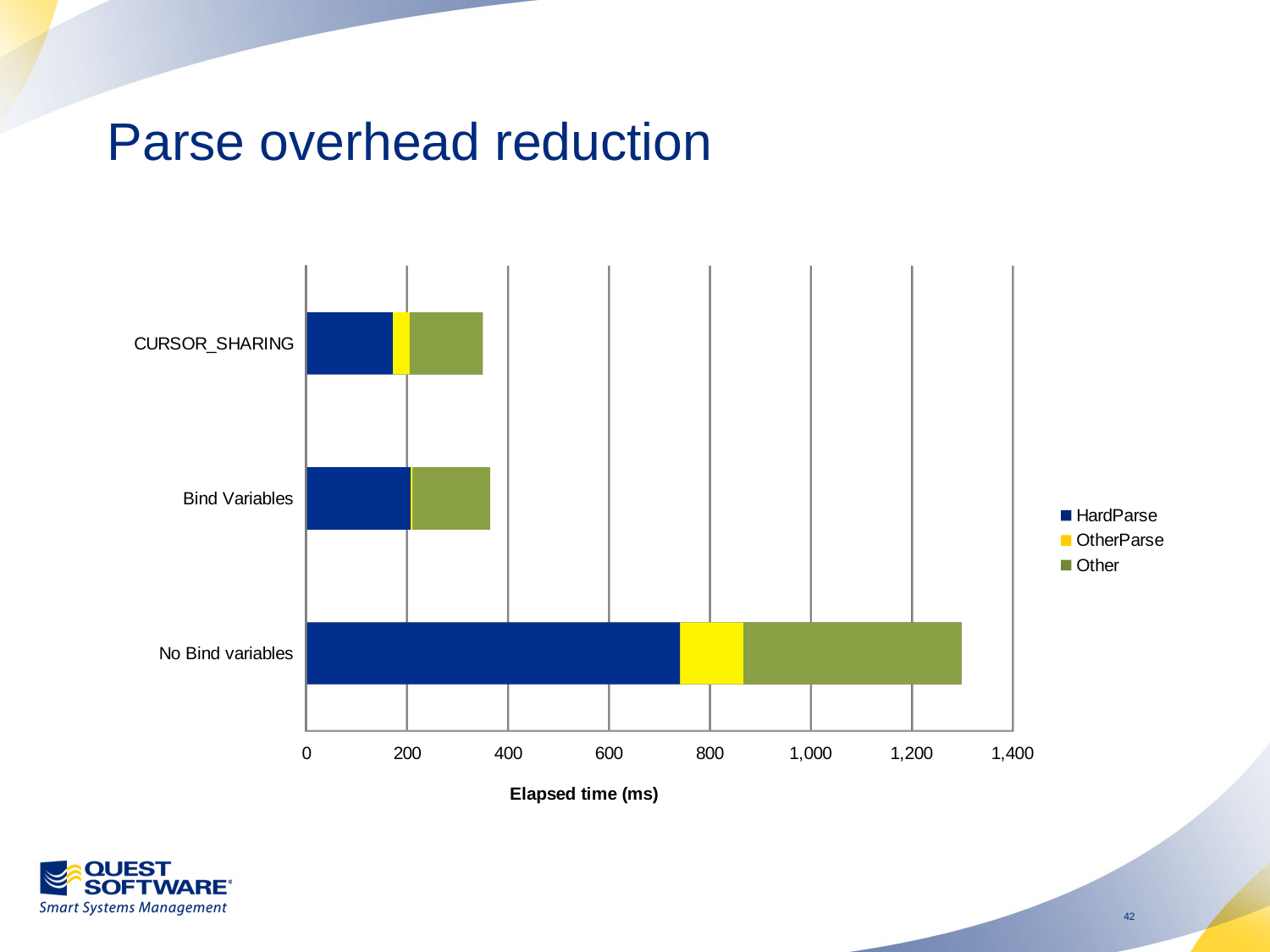
Is the HardParse value for No Bind variables greater or less than 600? greater How many series does the chart legend list? 3 Which series is shown in yellow in the legend? OtherParse How many categories are shown on the vertical axis of the chart? 3 Which has a larger total elapsed time, No Bind variables or Bind Variables? No Bind variables Is the HardParse value for No Bind variables greater or less than 800? less Is the total elapsed time for No Bind variables greater or less than 1,200? greater What is the label of the horizontal axis? Elapsed time (ms) What kind of chart is shown on the slide? stacked bar chart Which category has the longest total bar? No Bind variables